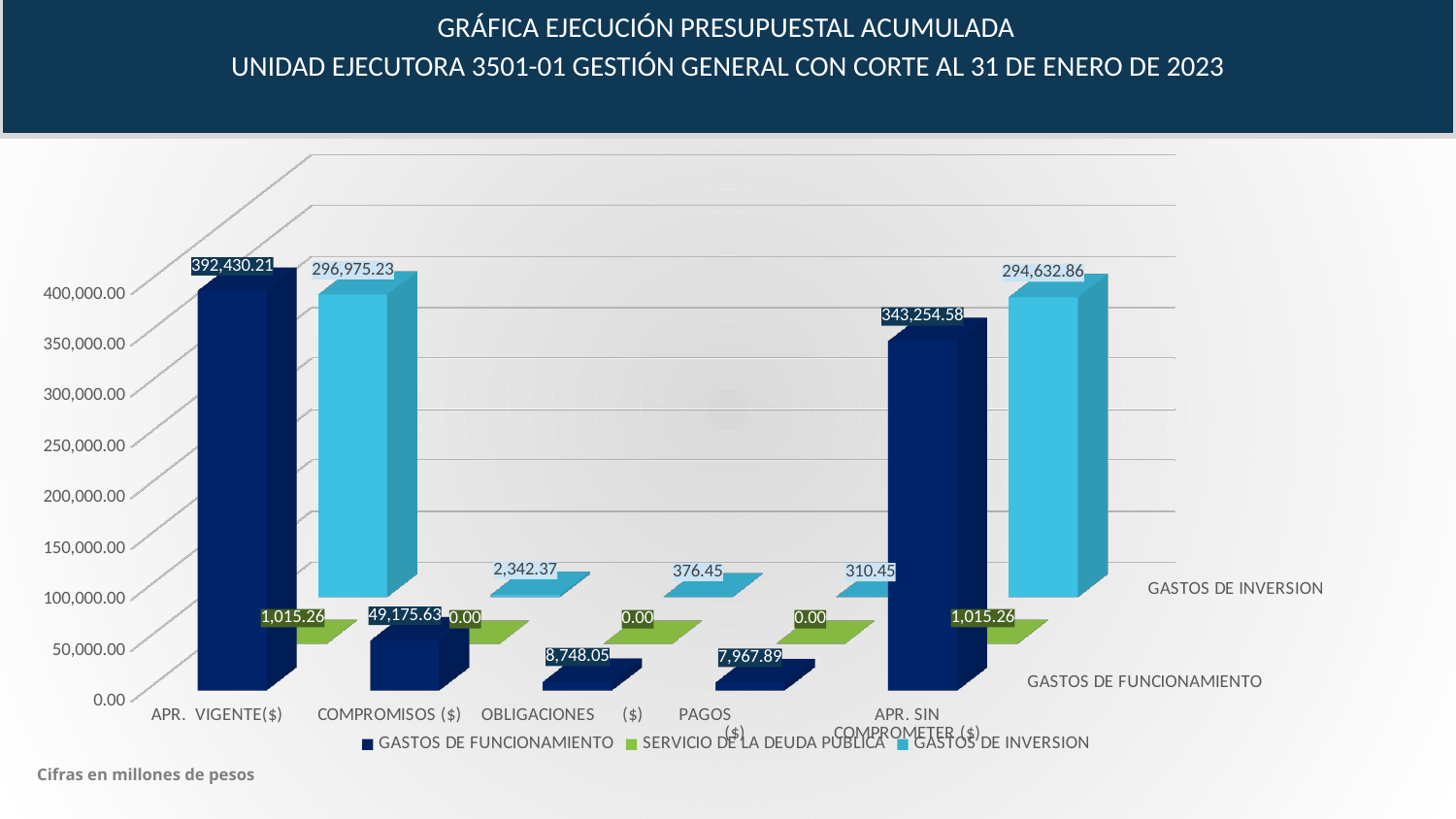
What is the value of SERVICIO DE LA DEUDA PÚBLICA for PAGOS ($)? 0.00 According to the note below the chart, in what units are the figures expressed? Millones de pesos What is the value of GASTOS DE FUNCIONAMIENTO for APR. VIGENTE($)? 392,430.21 What is the value of GASTOS DE FUNCIONAMIENTO for COMPROMISOS ($)? 49,175.63 How many categories are shown on the x axis? 5 What is the value of GASTOS DE INVERSION for APR. SIN COMPROMETER ($)? 294,632.86 What type of chart is shown on the slide? Bar chart How many series does the legend list? 3 What is the difference between GASTOS DE FUNCIONAMIENTO for APR. VIGENTE($) and for APR. SIN COMPROMETER ($)? 49,175.63 Which is larger: GASTOS DE INVERSION for OBLIGACIONES ($) or GASTOS DE INVERSION for PAGOS ($)? OBLIGACIONES ($) Which category has the highest value for GASTOS DE FUNCIONAMIENTO? APR. VIGENTE($) Which category has the lowest value for GASTOS DE INVERSION? PAGOS ($)